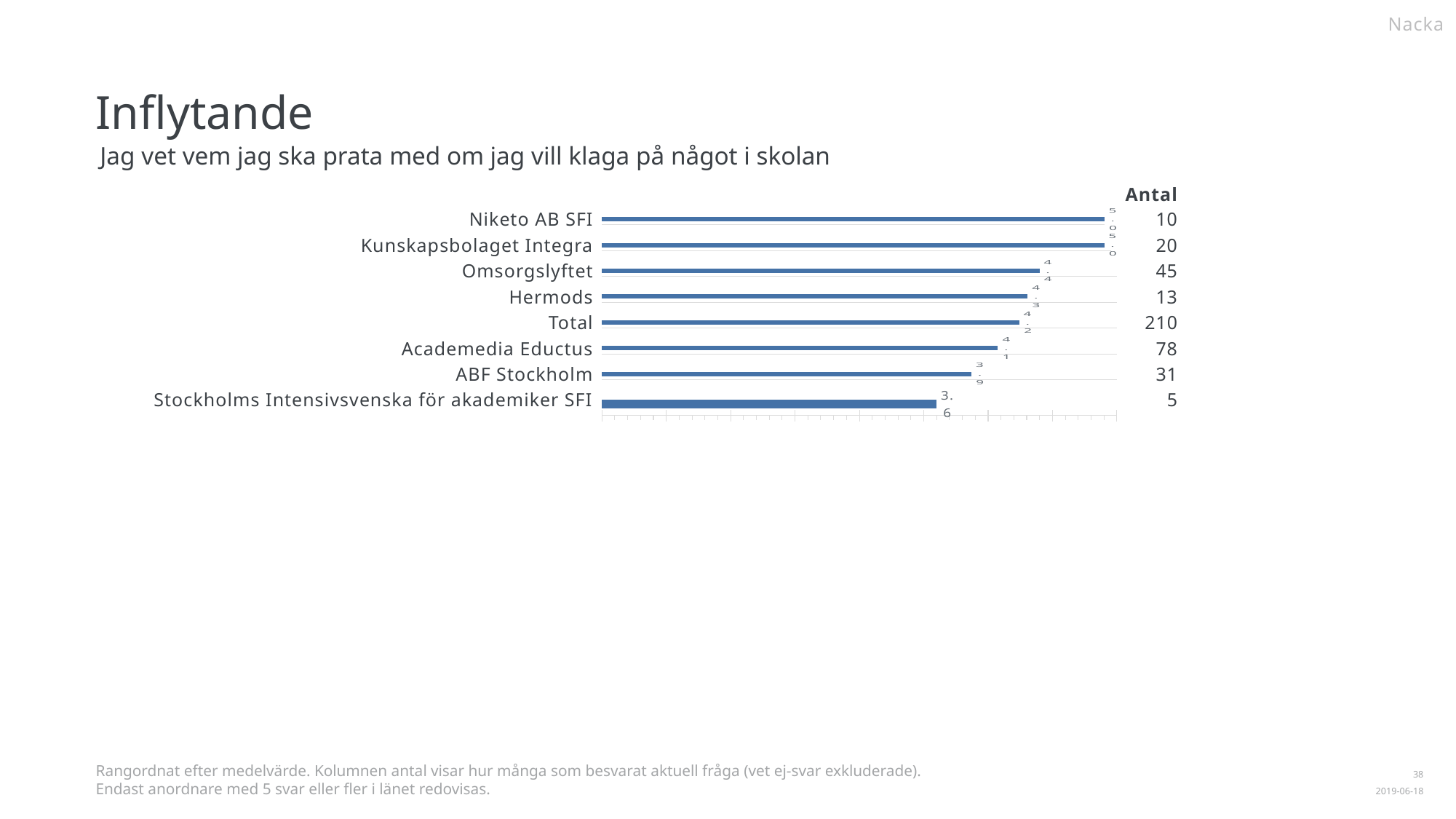
What is the value shown for ABF Stockholm? 3.9 What is the subtitle (question text) shown above the chart? Jag vet vem jag ska prata med om jag vill klaga på något i skolan What is the value shown for Hermods? 4.3 What is the heading of the number column to the right of the chart? Antal Which has the larger value, Hermods or ABF Stockholm? Hermods What is the value shown for Stockholms Intensivsvenska för akademiker SFI? 3.6 What is the value shown for Omsorgslyftet? 4.4 What kind of chart is shown on the slide? bar chart Which category has the lowest value in the chart? Stockholms Intensivsvenska för akademiker SFI What is the value shown for Total? 4.2 What is the difference between the values for Omsorgslyftet and Stockholms Intensivsvenska för akademiker SFI? 0.8 How many categories (bars) does the chart show? 8